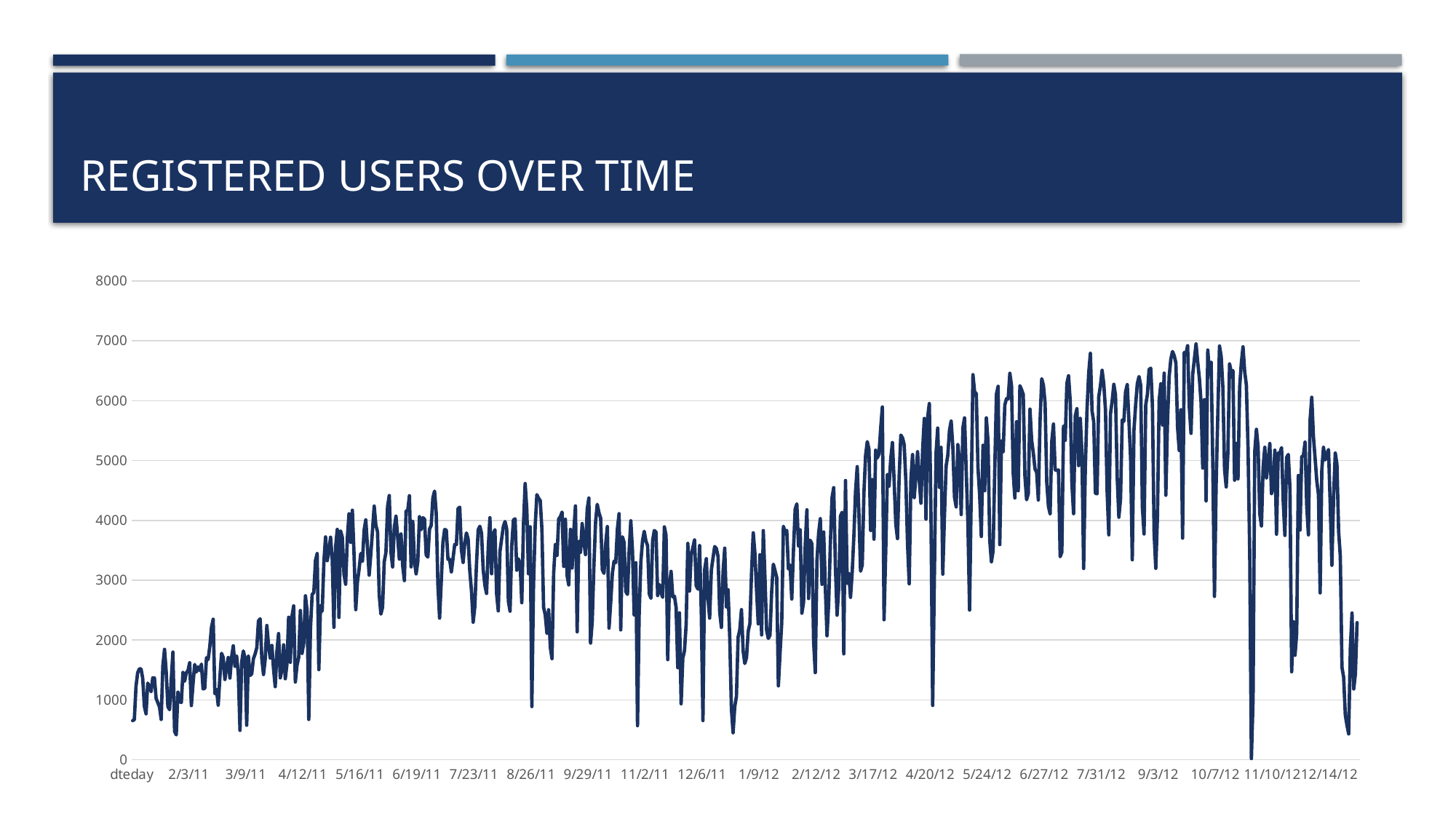
Is the lowest value on the chart greater or less than 1000? less Are the values around 2/3/11 greater or less than 3000? less What is the title of the chart? REGISTERED USERS OVER TIME Are the values around 9/3/12 greater or less than 4000? greater What is the highest value shown on the vertical axis? 8000 What kind of chart is shown on the slide? line chart Are the values around 2/3/11 higher or lower than the values around 9/3/12? lower Overall, do the values rise or fall from the start of 2011 to mid-2012? rise